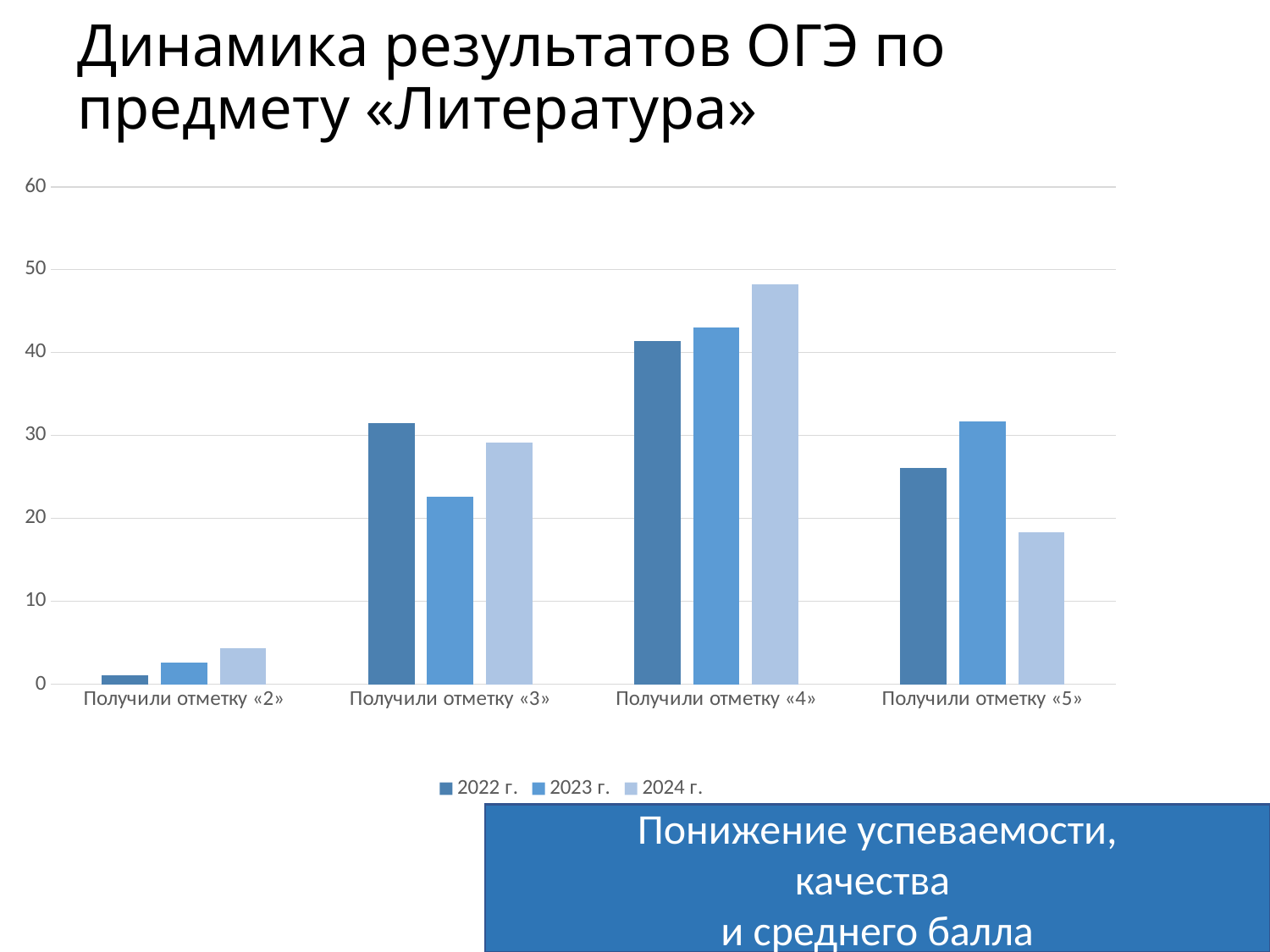
Which category has the lowest value for the 2022 г. series? Получили отметку «2» Do the bars for «Получили отметку «4»» rise or fall from 2022 г. to 2024 г.? rise Is the 2023 г. value for «Получили отметку «3»» greater or less than 30? less For «Получили отметку «5»», which is larger: the 2023 г. value or the 2024 г. value? 2023 г. For «Получили отметку «3»», which is larger: the 2022 г. value or the 2023 г. value? 2022 г. What kind of chart is shown on the slide? bar chart How many categories are shown on the x axis? 4 Is the 2024 г. value for «Получили отметку «4»» greater or less than 40? greater What are the entries listed in the legend? 2022 г., 2023 г., 2024 г. Is the 2024 г. value for «Получили отметку «5»» greater or less than 20? less Which category has the highest value for the 2024 г. series? Получили отметку «4» How many series does the legend list? 3